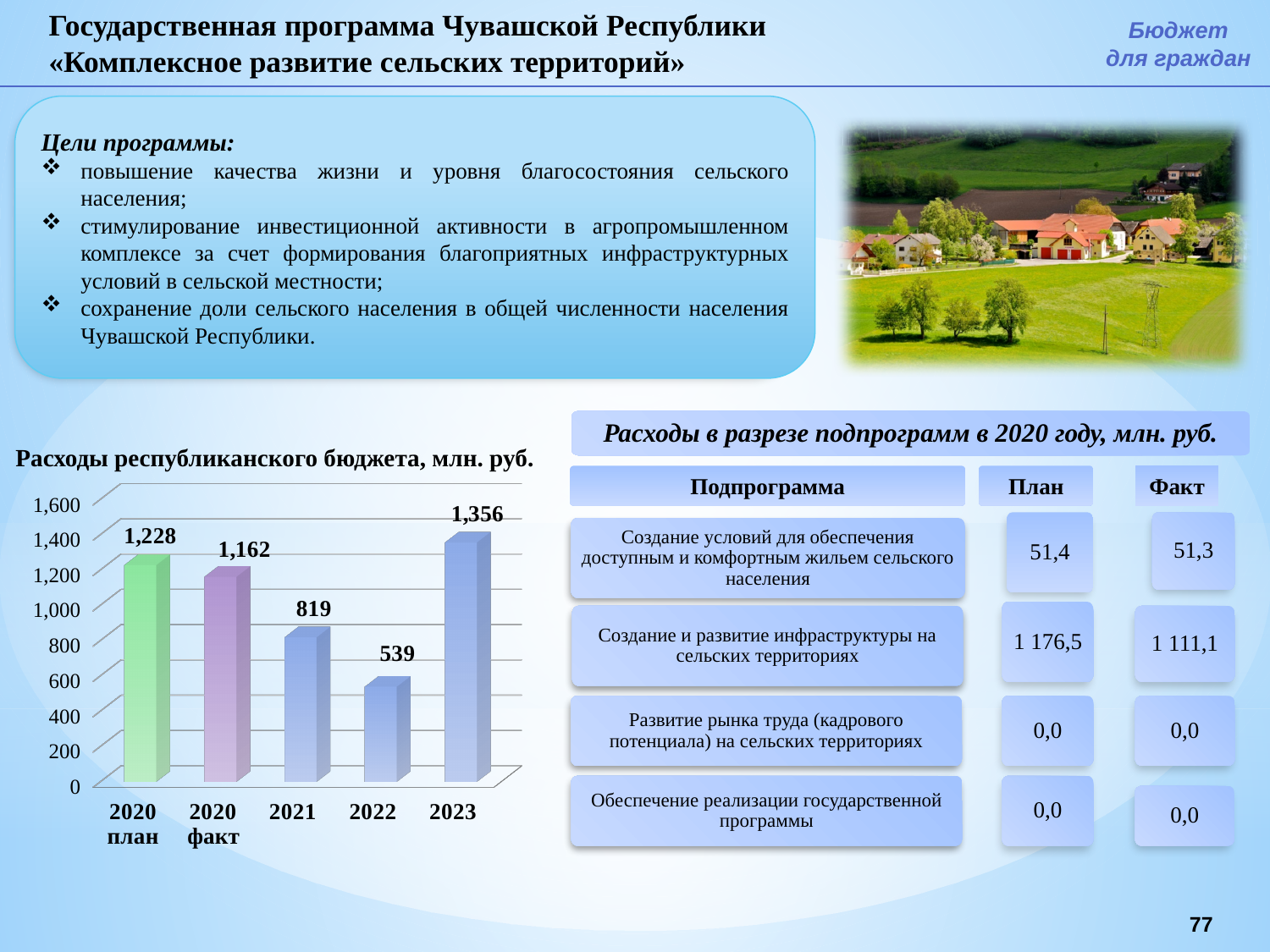
Is the value for 2021 greater or less than 1,000? less Which category has the lowest value in the chart? 2022 What is the value for 2023 in the chart? 1,356 Which is larger, the value for 2021 or the value for 2023? 2023 What kind of chart is shown on the slide? bar chart Which category has the highest value in the chart? 2023 What is the value for 2020 факт in the chart? 1,162 How many bars are shown in the chart? 5 What is the value for 2020 план in the chart 'Расходы республиканского бюджета, млн. руб.'? 1,228 What is the value for 2022 in the chart? 539 What is the difference between the values for 2020 план and 2020 факт? 66 What is the difference between the values for 2021 and 2022? 280